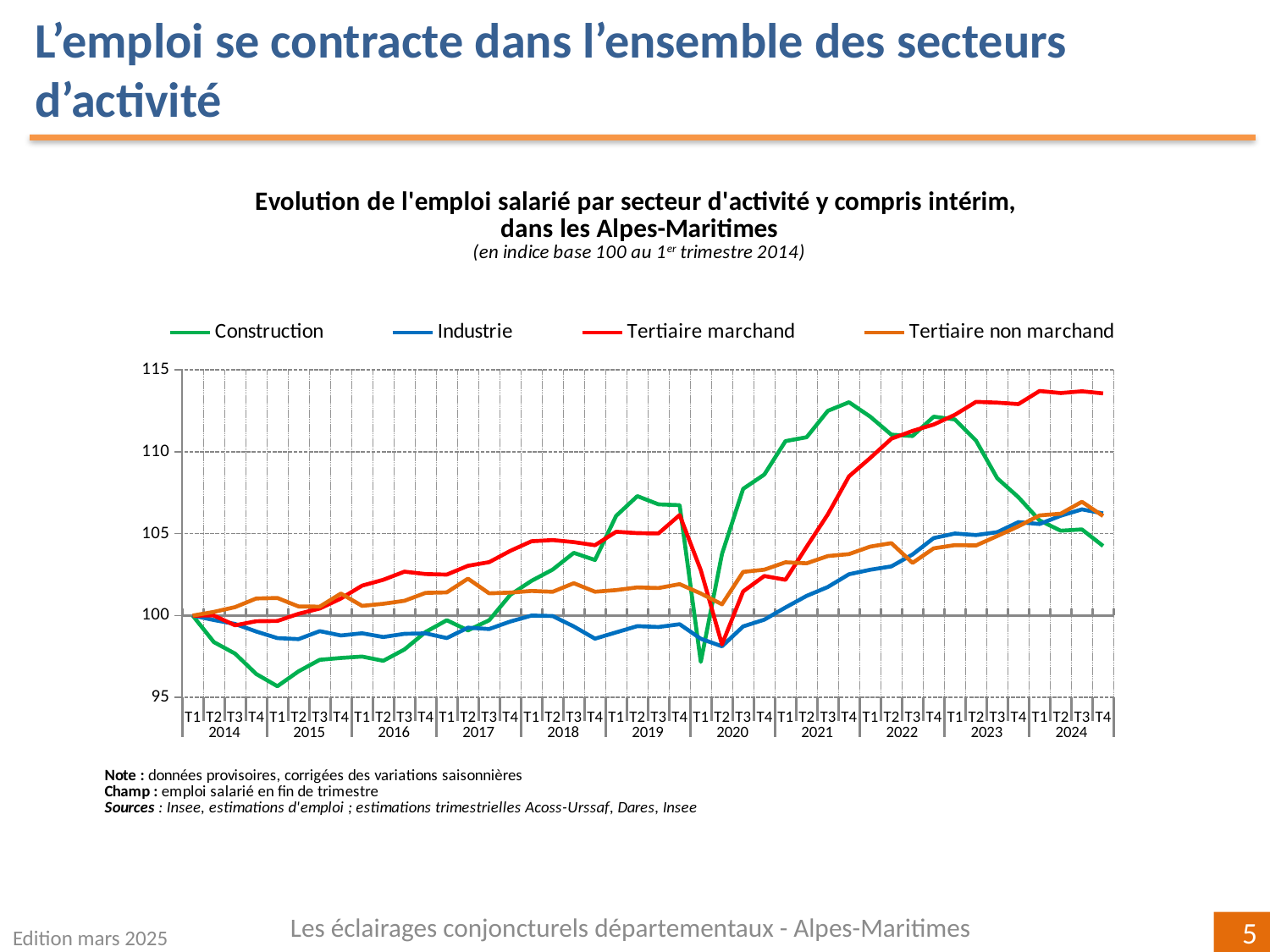
Which series has the lowest value at T1 2015? Construction Which series has the highest value at T4 2024? Tertiaire marchand Is the value for Construction at T4 2021 greater or less than 110? greater Is the value for Construction at T1 2020 greater or less than 100? less Does the Construction series rise or fall between T1 2014 and T1 2015? fall Which series is drawn in red? Tertiaire marchand At T4 2021, which is larger: Construction or Industrie? Construction What kind of chart is shown on the slide? line chart What is the index value of all four series at T1 2014? 100 How many years are labelled on the x axis? 11 Is the value for Tertiaire marchand at T4 2024 greater or less than 110? greater How many series does the legend list? 4